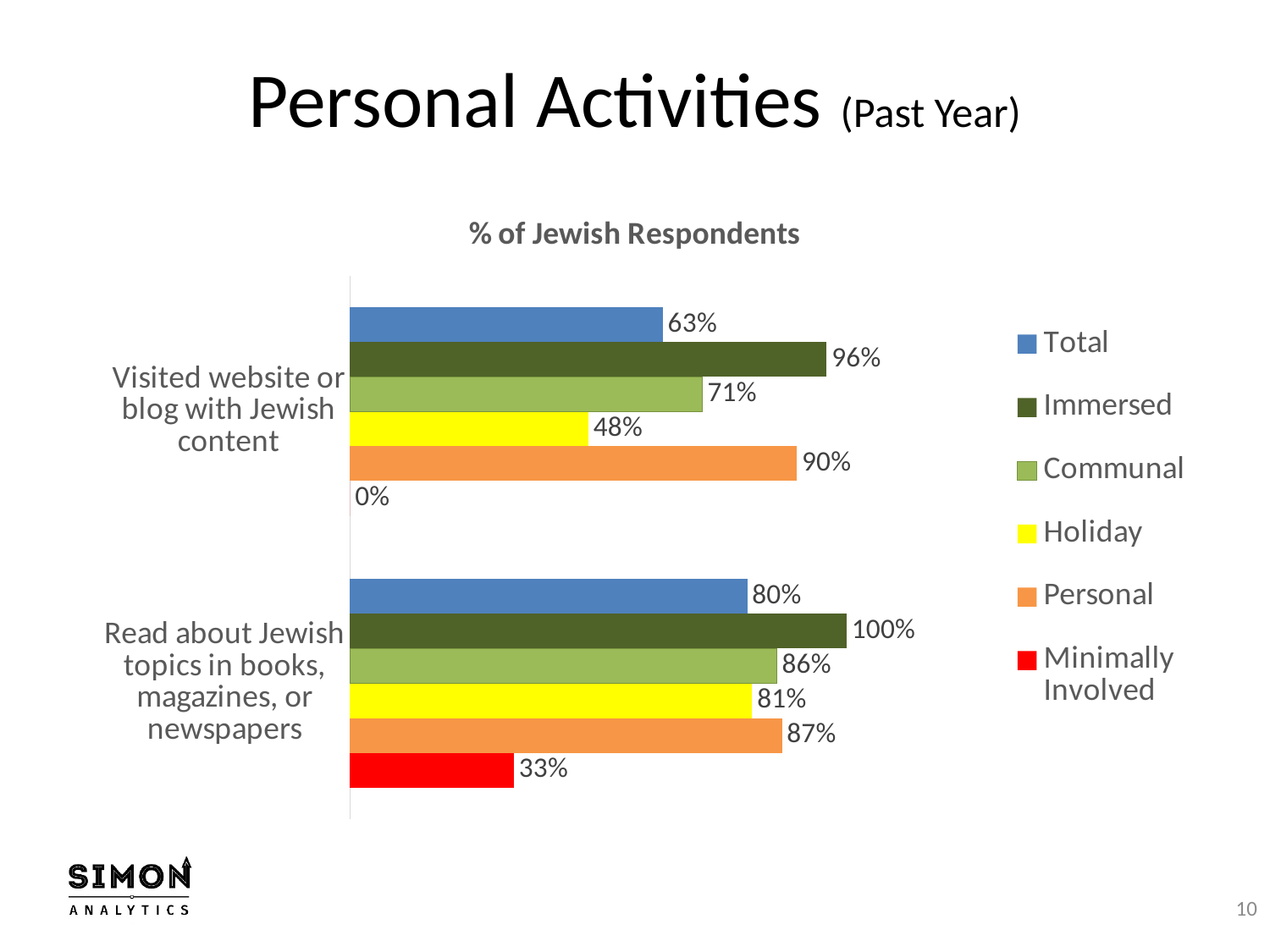
How many series does the legend list? 6 What is the Holiday value for visiting a website or blog with Jewish content? 48% What percentage of Immersed respondents visited a website or blog with Jewish content? 96% Which group has the lowest value for visiting a website or blog with Jewish content? Minimally Involved For reading about Jewish topics, which is larger: the Communal value or the Personal value? Personal What is the Total value for reading about Jewish topics in books, magazines, or newspapers? 80% Which group has the highest value for reading about Jewish topics in books, magazines, or newspapers? Immersed What kind of chart is shown on the slide? Bar chart What percentage of Minimally Involved respondents read about Jewish topics in books, magazines, or newspapers? 33% How many activity categories are shown on the chart? 2 What is the title of the chart? % of Jewish Respondents What is the difference between the Personal and Holiday values for visiting a website or blog with Jewish content? 42%